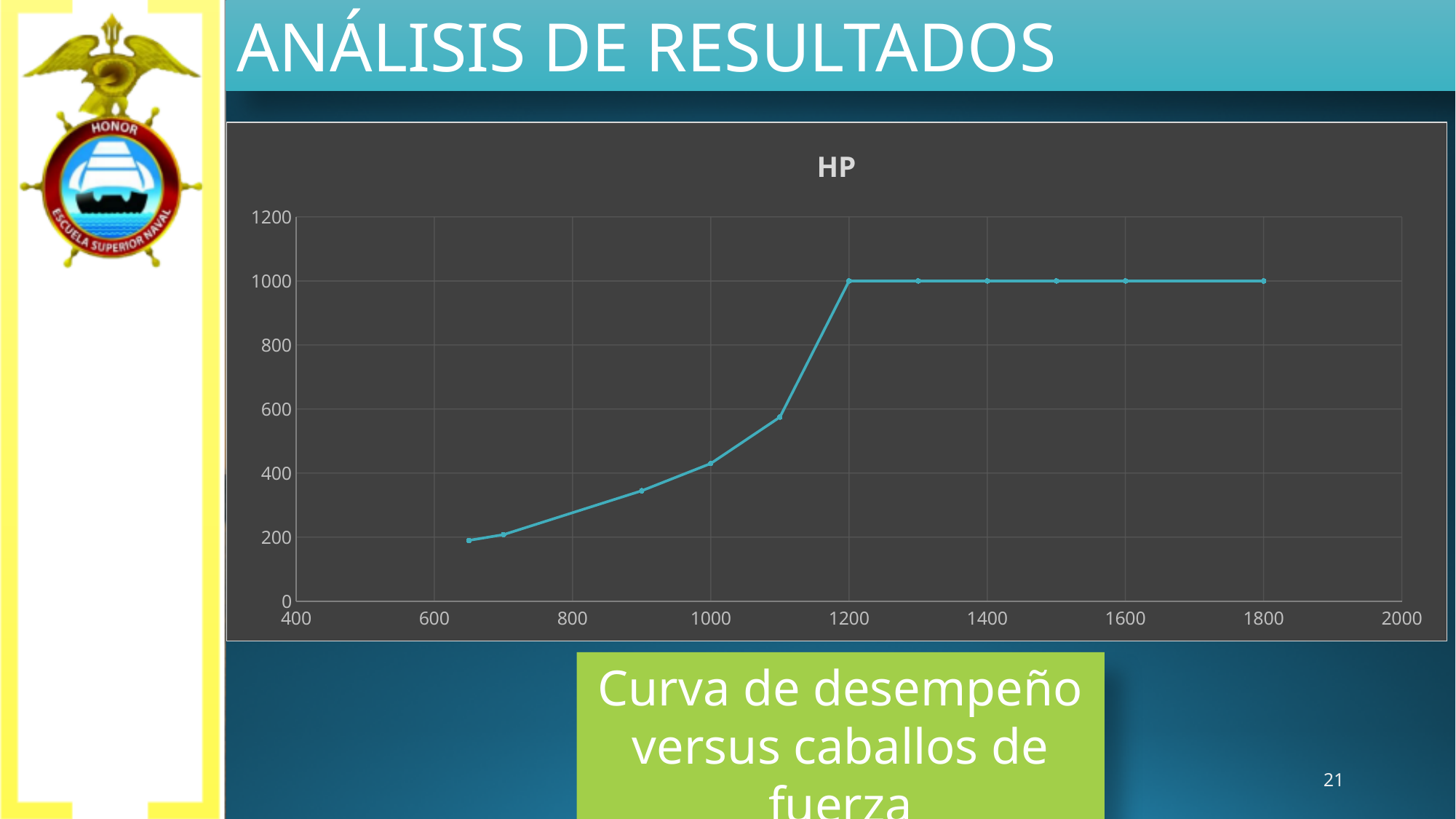
What is the value of the line at x = 1200? 1000 Is the value at x = 1100 greater or less than 600? less What is the maximum value shown on the x axis? 2000 Is the value at x = 1000 greater or less than 400? greater Do the values rise or fall as x increases from 600 to 1200? rise Is the value at x = 900 greater or less than 400? less What is the title of the chart? HP Which has the larger value, the point at x = 1000 or the point at x = 1100? x = 1100 How many data points are plotted on the line? 11 What is the value of the line at x = 1800? 1000 What kind of chart is shown on the slide? line chart What is the highest value reached by the line? 1000